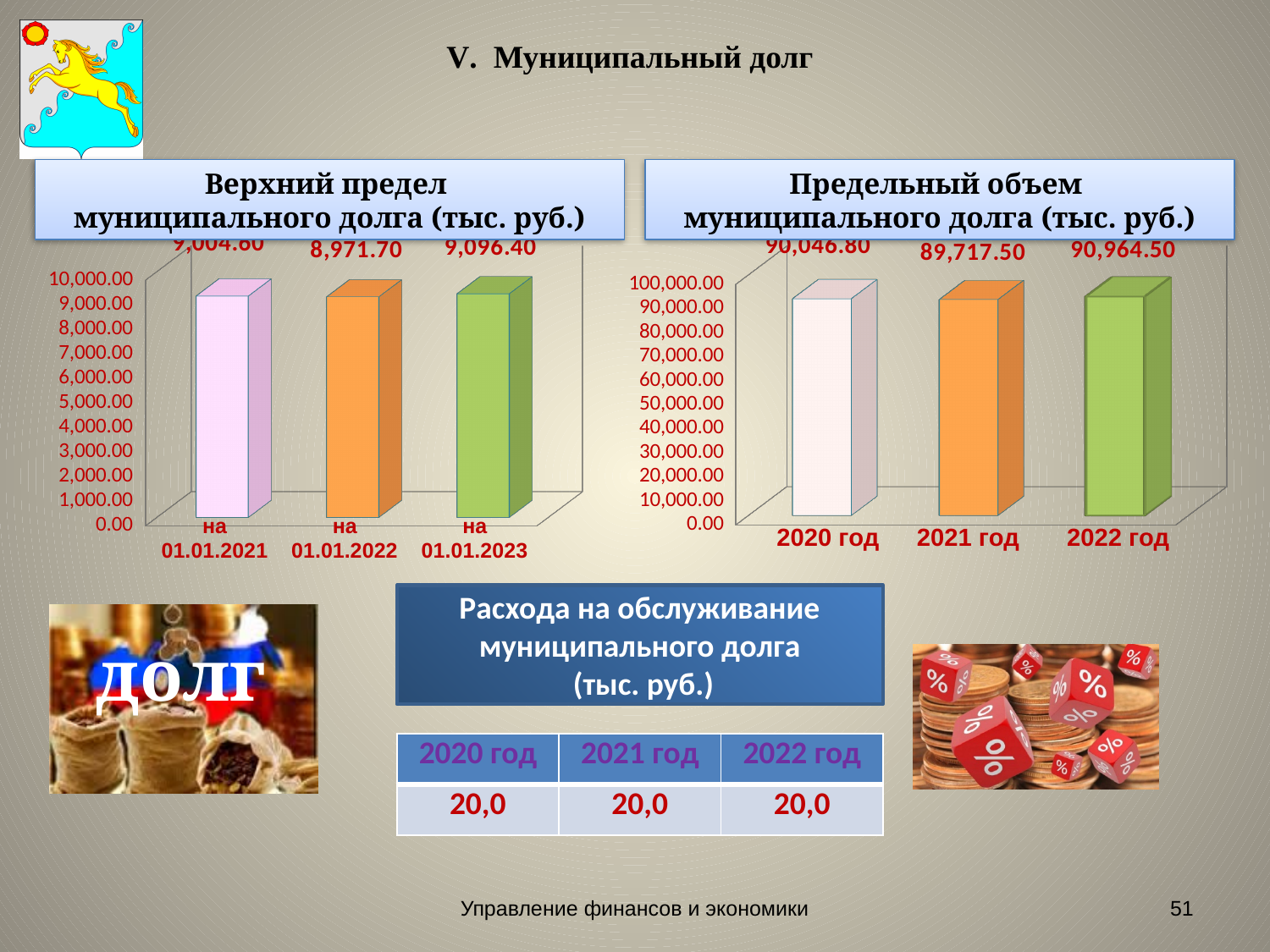
In the chart 'Верхний предел муниципального долга (тыс. руб.)', what is the value for на 01.01.2022? 8,971.70 In the chart 'Верхний предел муниципального долга (тыс. руб.)', which is larger: the value for на 01.01.2022 or на 01.01.2023? на 01.01.2023 In the chart 'Предельный объем муниципального долга (тыс. руб.)', what is the value for 2022 год? 90,964.50 In the chart 'Предельный объем муниципального долга (тыс. руб.)', what is the value for 2021 год? 89,717.50 In the chart 'Верхний предел муниципального долга (тыс. руб.)', what is the difference between the values for на 01.01.2023 and на 01.01.2022? 124.70 In the chart 'Предельный объем муниципального долга (тыс. руб.)', which year has the highest value? 2022 год In the chart 'Предельный объем муниципального долга (тыс. руб.)', which year has the lowest value? 2021 год In the chart 'Предельный объем муниципального долга (тыс. руб.)', what is the difference between the values for 2022 год and 2021 год? 1,247.00 How many bars are shown in the chart 'Предельный объем муниципального долга (тыс. руб.)'? 3 What type of chart is 'Верхний предел муниципального долга (тыс. руб.)'? Bar chart In the chart 'Верхний предел муниципального долга (тыс. руб.)', is the value for на 01.01.2022 greater or less than 9,000.00? less In the chart 'Верхний предел муниципального долга (тыс. руб.)', what is the value for на 01.01.2023? 9,096.40